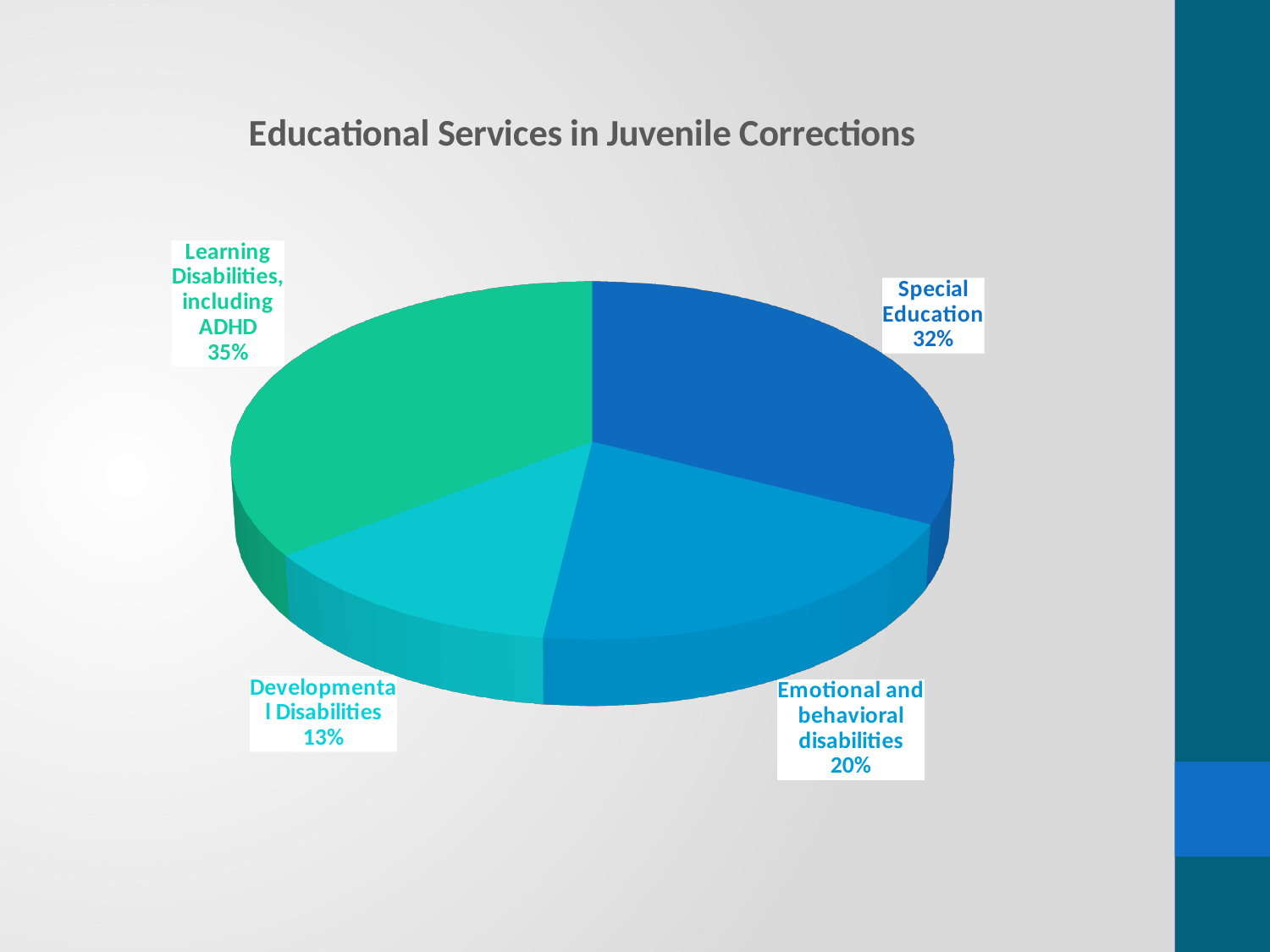
How many categories are shown in the pie chart? 4 What is the title of the chart? Educational Services in Juvenile Corrections What kind of chart is shown on the slide? Pie chart Which category has the smallest share of the pie? Developmental Disabilities Which is larger, the share for Emotional and behavioral disabilities or the share for Developmental Disabilities? Emotional and behavioral disabilities What percentage is shown for Special Education? 32% What percentage is shown for Learning Disabilities, including ADHD? 35% Which category has the largest share of the pie? Learning Disabilities, including ADHD What percentage is shown for Emotional and behavioral disabilities? 20% What is the difference in percentage points between Emotional and behavioral disabilities and Developmental Disabilities? 7 What is the difference in percentage points between Learning Disabilities, including ADHD and Special Education? 3 What percentage is shown for Developmental Disabilities? 13%